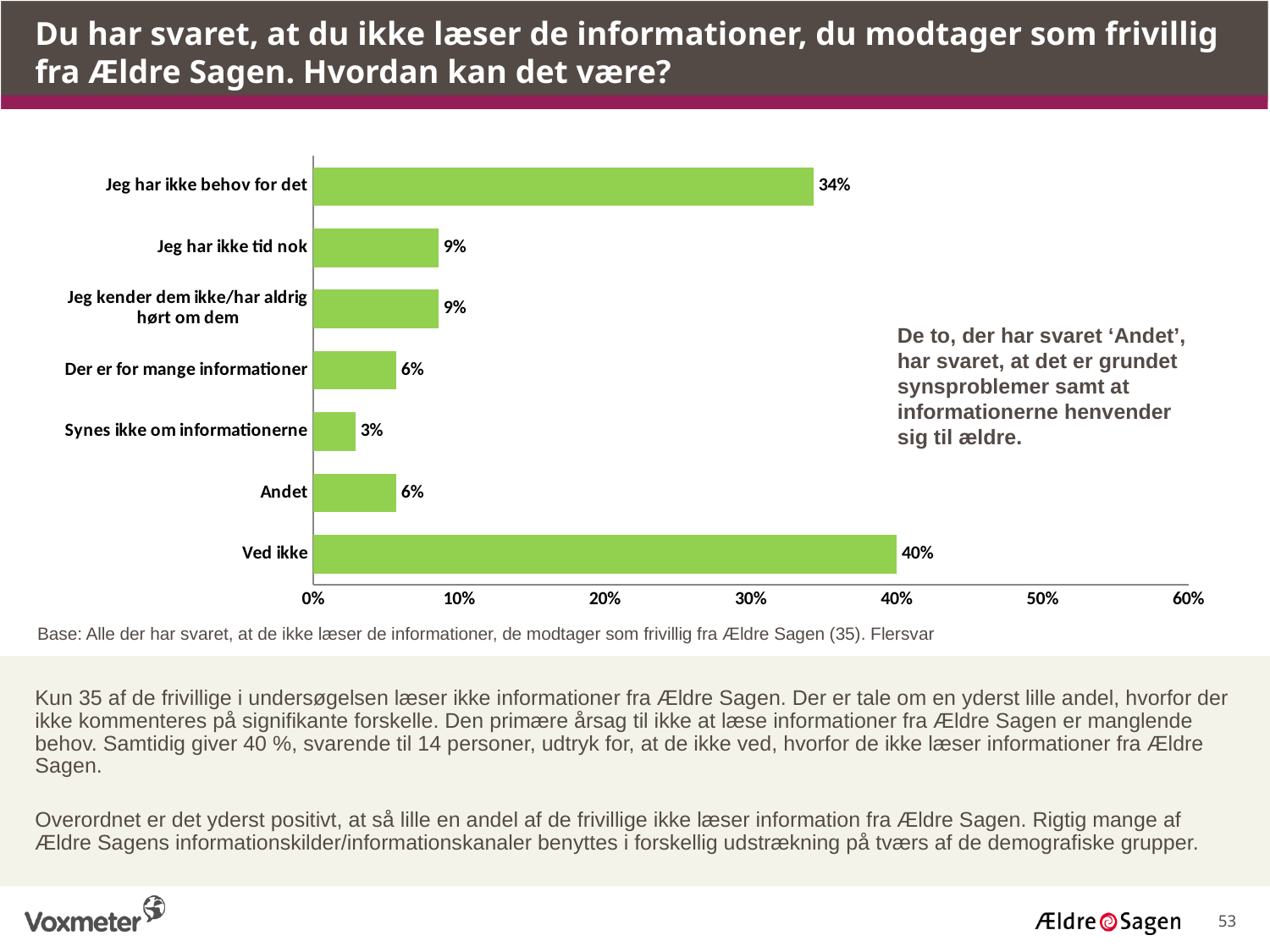
How many categories are shown in the chart? 7 What is the value for "Ved ikke"? 40% What is the value for "Synes ikke om informationerne"? 3% Which category has the highest value? Ved ikke Which is larger, the value for "Jeg har ikke tid nok" or the value for "Andet"? Jeg har ikke tid nok What is the highest value shown on the x axis? 60% What kind of chart is shown on the slide? bar chart What is the value for "Der er for mange informationer"? 6% What is the value for "Jeg har ikke behov for det"? 34% Is the value for "Jeg har ikke behov for det" greater or less than 30%? greater Which category has the lowest value? Synes ikke om informationerne What is the difference between the values for "Ved ikke" and "Jeg har ikke behov for det"? 6%